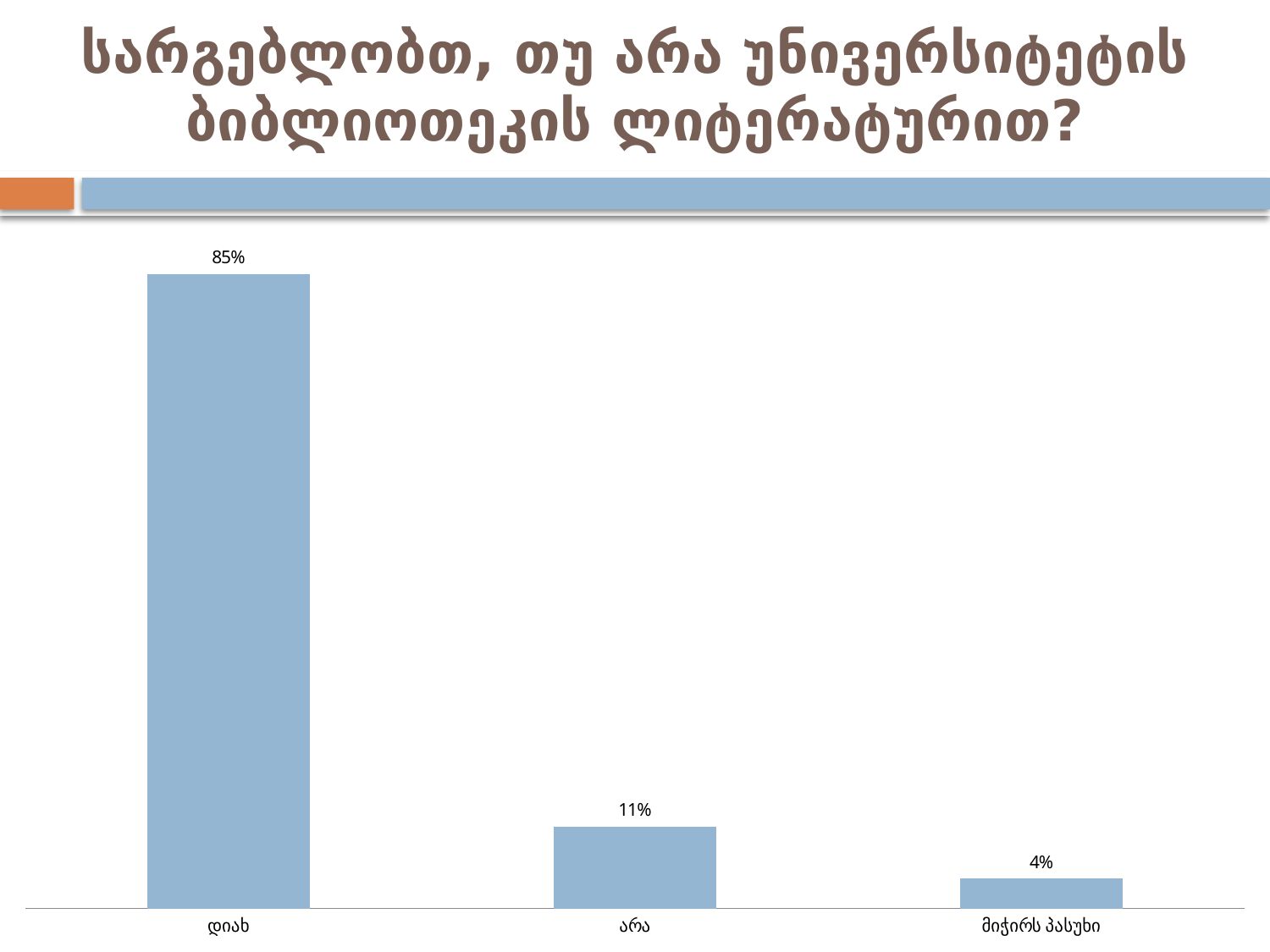
What is the difference between the values for არა and მიჭირს პასუხი? 7% Which is larger, the value for არა or the value for მიჭირს პასუხი? არა What is the value for დიახ? 85% What kind of chart is shown on the slide? bar chart What is the value for მიჭირს პასუხი? 4% Which category has the highest value? დიახ What is the difference between the values for დიახ and არა? 74% What is the title of the slide? სარგებლობთ, თუ არა უნივერსიტეტის ბიბლიოთეკის ლიტერატურით? How many categories are shown in the chart? 3 What is the value for არა? 11% Do the values rise or fall from left to right across the categories? fall Which category has the lowest value? მიჭირს პასუხი